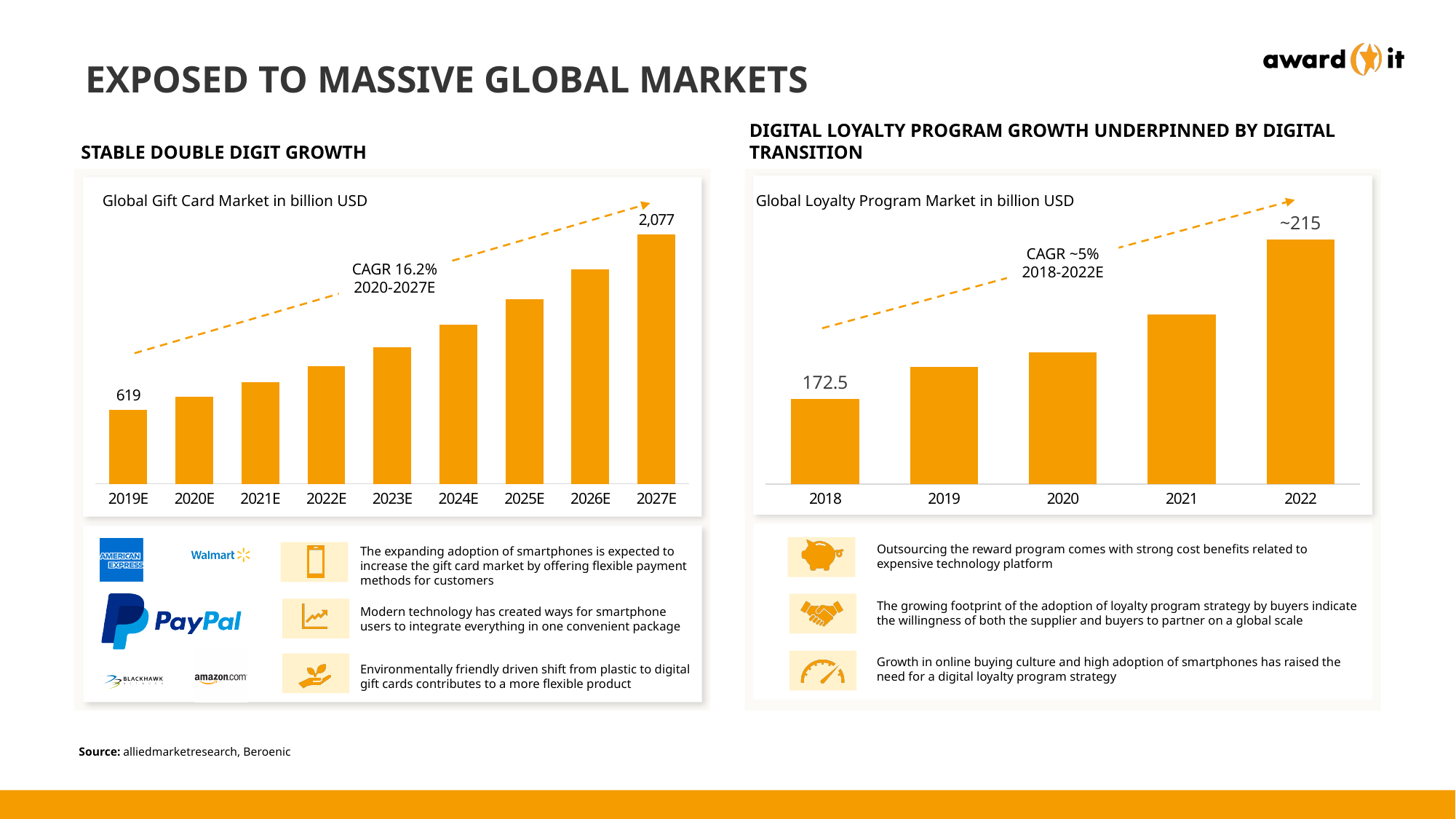
In the Global Loyalty Program Market chart, what is the value for 2018? 172.5 How many bars are in the Global Loyalty Program Market chart? 5 How many years are shown on the x axis of the Global Gift Card Market chart? 9 In the Global Gift Card Market chart, which year has the highest value? 2027E In the Global Loyalty Program Market chart, which is larger, the value for 2020 or the value for 2021? 2021 In the Global Gift Card Market chart, what is the value for 2019E? 619 In the Global Loyalty Program Market chart, which year has the lowest value? 2018 In the Global Gift Card Market chart, what is the value for 2027E? 2,077 In the Global Gift Card Market chart, what is the difference between the 2027E and 2019E values? 1,458 What type of chart is the Global Loyalty Program Market chart? Bar chart In the Global Gift Card Market chart, what CAGR is stated for 2020-2027E? 16.2% In the Global Loyalty Program Market chart, what value is labelled for 2022? ~215